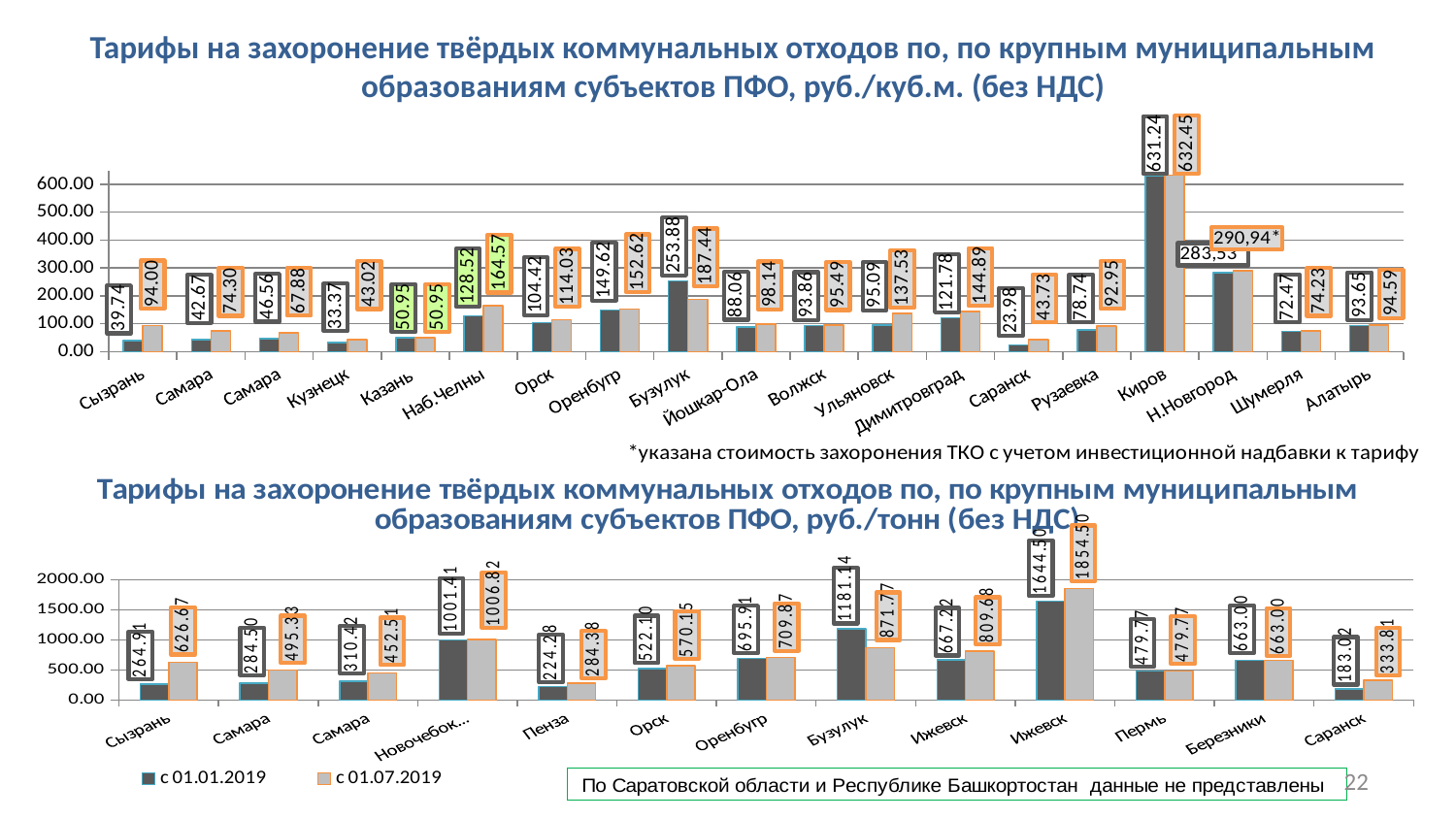
What kind of chart is the bottom chart (руб./тонн)? Bar chart How many series does the legend of the bottom chart (руб./тонн) list? 2 In the top chart (руб./куб.м.), what is the difference between the с 01.01.2019 and с 01.07.2019 values for Бузулук? 66.44 In the top chart (руб./куб.м.), what is the value for Наб.Челны for the series с 01.01.2019? 128.52 In the bottom chart (руб./тонн), which series has the larger value for Бузулук, с 01.01.2019 or с 01.07.2019? с 01.01.2019 In the top chart (руб./куб.м.), which category has the lowest value for the series с 01.01.2019? Саранск In the bottom chart (руб./тонн), what is the difference between the с 01.07.2019 and с 01.01.2019 values for Саранск? 150.79 How many categories are shown on the x axis of the top chart (руб./куб.м.)? 19 In the top chart (руб./куб.м.), what is the value for Киров for the series с 01.07.2019? 632.45 In the bottom chart (руб./тонн), what is the value for Пенза for the series с 01.07.2019? 284.38 In the top chart (руб./куб.м.), which category has the highest value for the series с 01.01.2019? Киров In the bottom chart (руб./тонн), which category has the highest value for the series с 01.07.2019? Ижевск